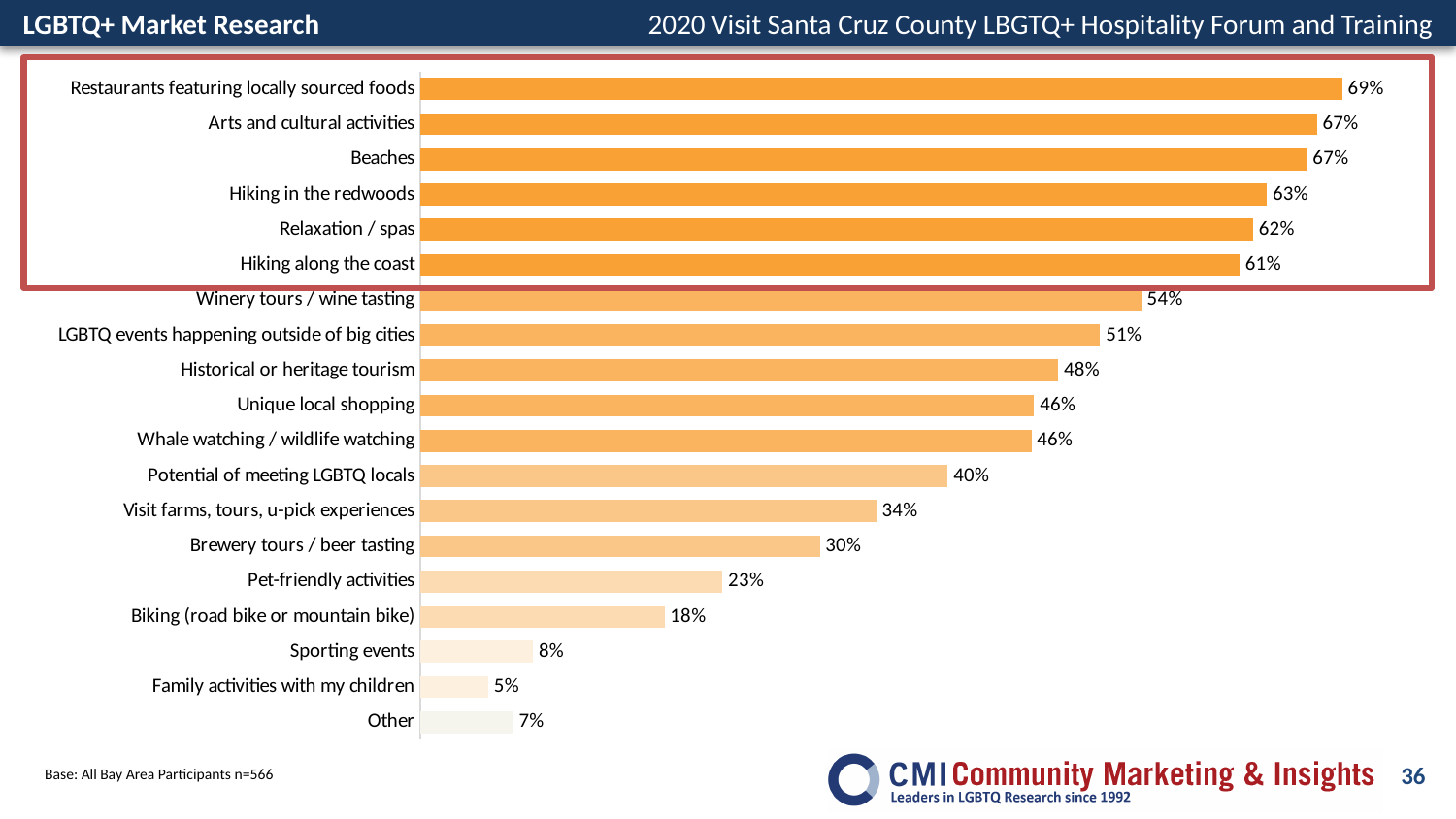
Which category has the lowest value in the chart? Family activities with my children What percentage is shown for Biking (road bike or mountain bike)? 18% How many categories are plotted in the chart? 19 What is the difference between the values for Brewery tours / beer tasting and Pet-friendly activities? 7% Which category has the highest value in the chart? Restaurants featuring locally sourced foods What is the base (sample size) noted at the bottom of the slide? All Bay Area Participants n=566 What percentage is shown for Restaurants featuring locally sourced foods? 69% Which is larger, the value for Potential of meeting LGBTQ locals or the value for Visit farms, tours, u-pick experiences? Potential of meeting LGBTQ locals What is the difference between the values for Hiking in the redwoods and Hiking along the coast? 2% Which is larger, the value for Sporting events or the value for Other? Sporting events What is the value for Winery tours / wine tasting? 54% What kind of chart is shown on the slide? Bar chart